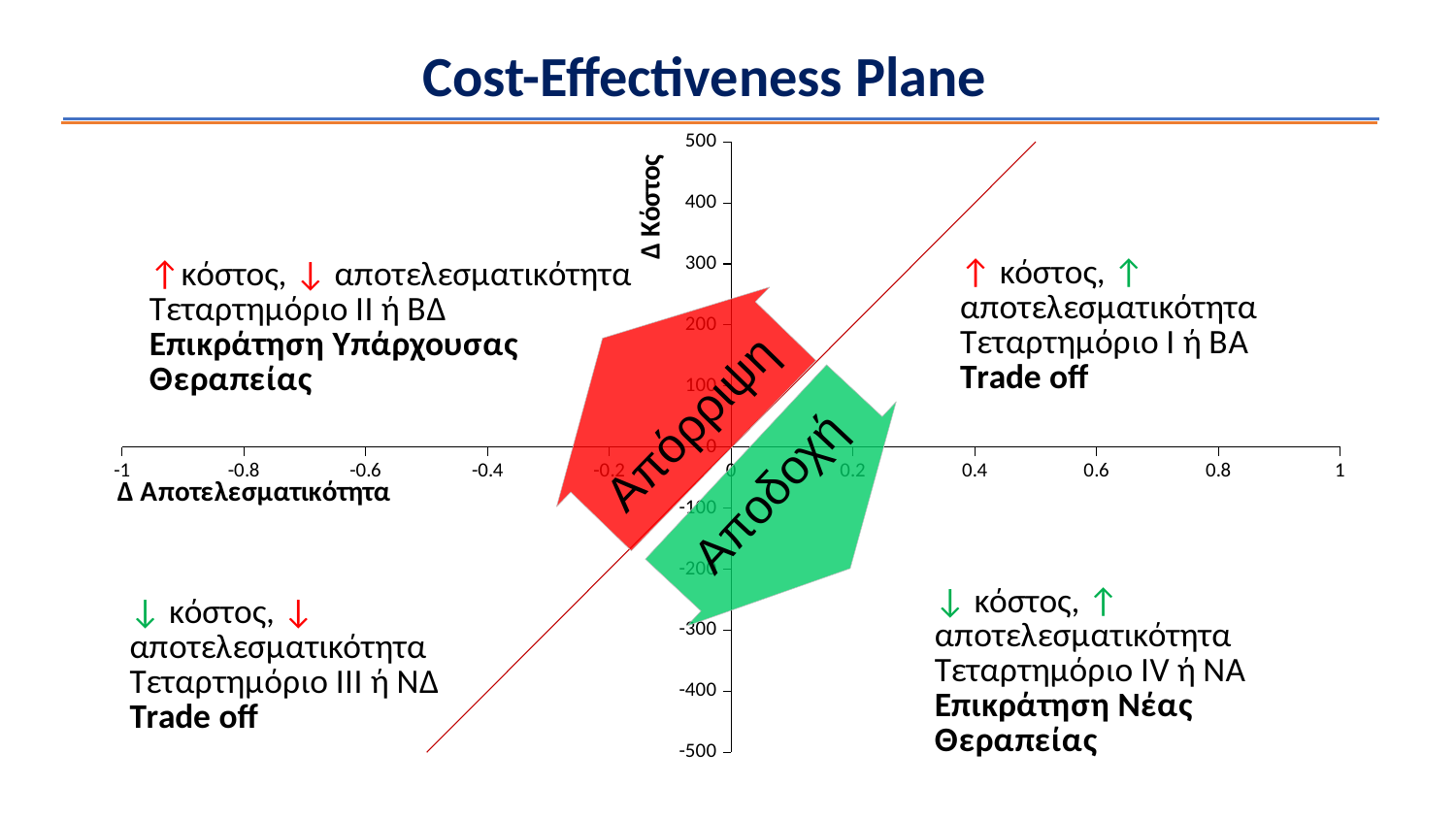
What is the highest value shown on the horizontal axis of the chart? 1 What is the lowest value shown on the vertical axis of the chart? -500 What is the label of the vertical axis of the chart? Δ Κόστος What is the lowest value shown on the horizontal axis of the chart? -1 What is the title of the chart on the slide? Cost-Effectiveness Plane What is the highest value shown on the vertical axis of the chart? 500